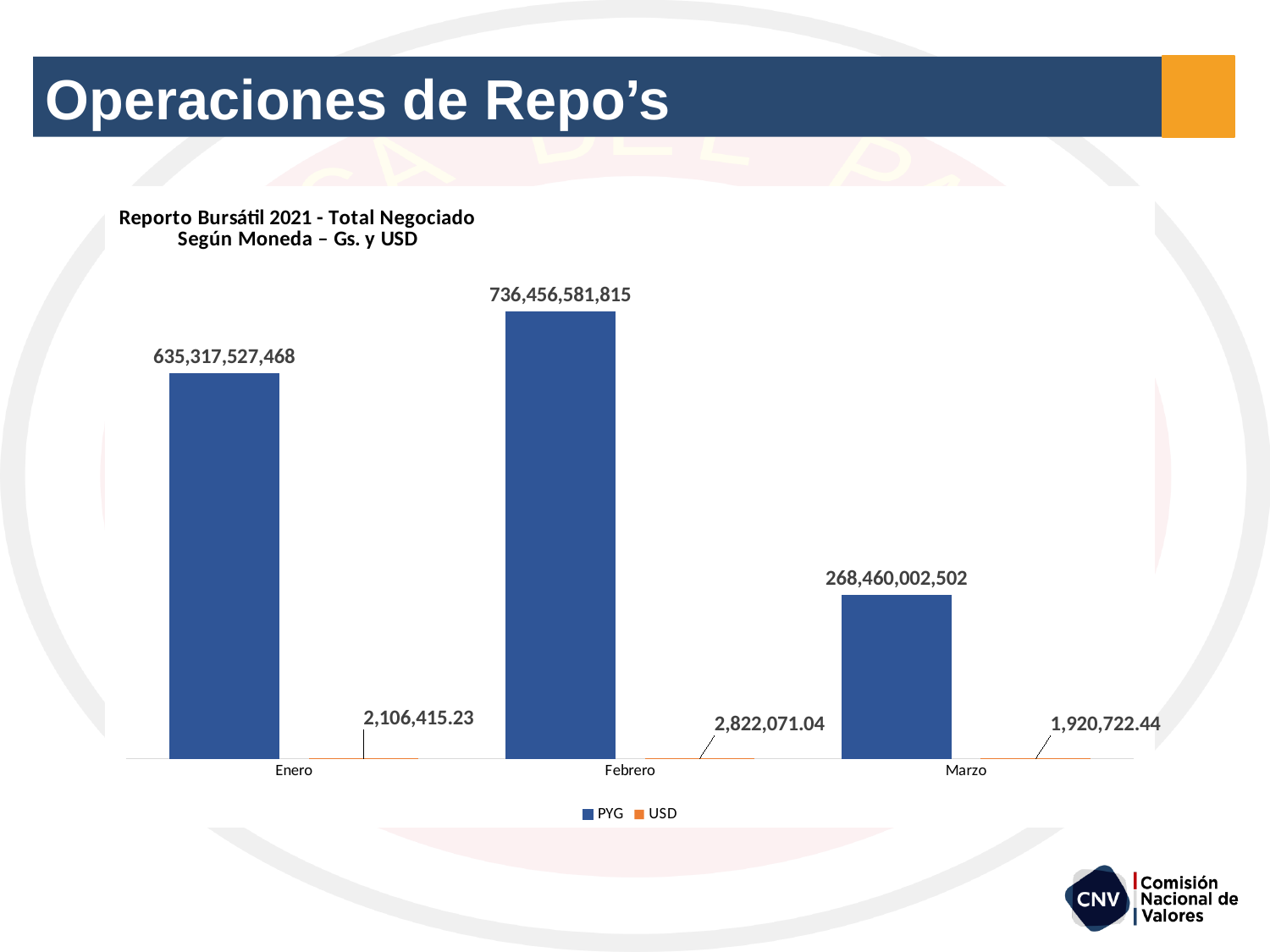
What is the USD value for Marzo? 1,920,722.44 Which month has the highest PYG value? Febrero How many months are shown on the x axis? 3 What is the PYG value for Enero? 635,317,527,468 What is the USD value for Enero? 2,106,415.23 Which month has the lowest USD value? Marzo What is the difference between the USD values for Febrero and Marzo? 901,348.60 What is the difference between the PYG values for Febrero and Enero? 101,139,054,347 How many series does the legend list? 2 Which is larger, the PYG value for Enero or the PYG value for Marzo? Enero What is the PYG value for Febrero? 736,456,581,815 What kind of chart is shown on the slide? Bar chart